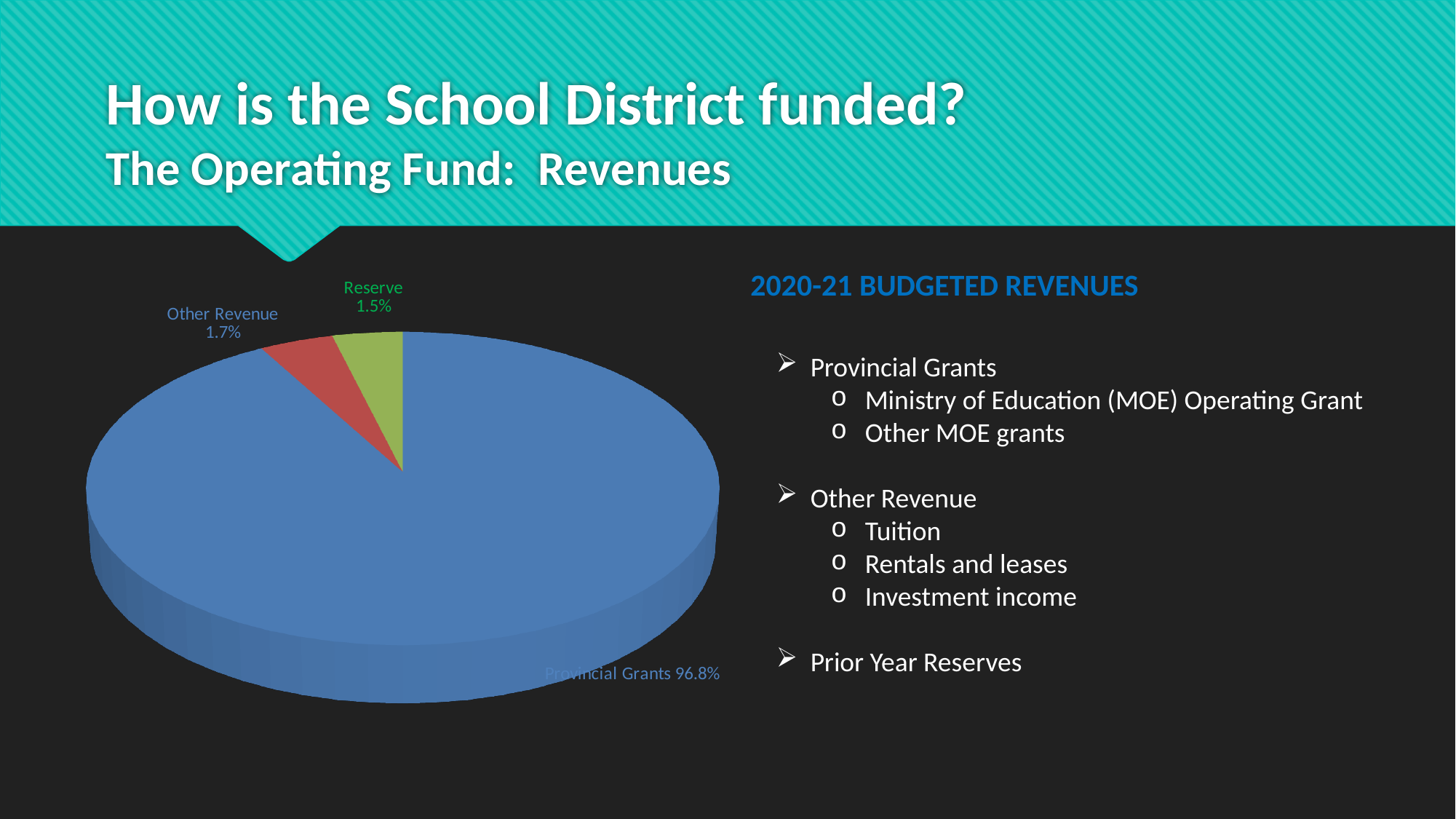
Which slice of the pie is the largest? Provincial Grants What share of the pie does Provincial Grants represent? 96.8% What share of the pie does Other Revenue represent? 1.7% What colour is the Reserve slice? green What share of the pie does Reserve represent? 1.5% What is the difference in percentage points between Other Revenue and Reserve? 0.2% How many slices does the pie chart have? 3 Which is larger, the Other Revenue slice or the Reserve slice? Other Revenue What is the difference in percentage points between Provincial Grants and Other Revenue? 95.1% What kind of chart is shown on the slide? pie chart What colour is the Provincial Grants slice? blue Which slice of the pie is the smallest? Reserve